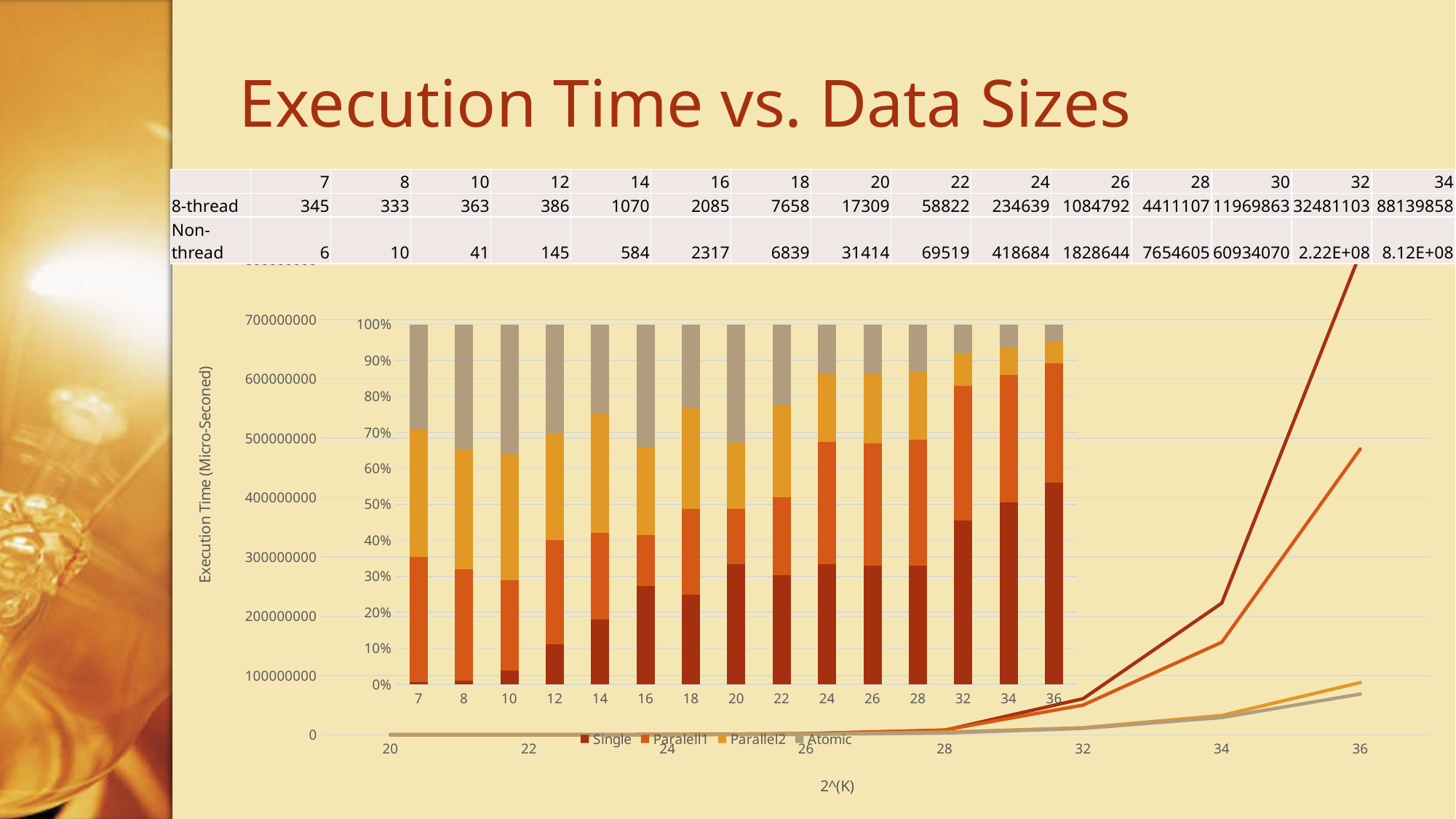
In the stacked bar chart, which category has the largest Single share? 36 In the stacked bar chart, is the Single share for category 8 greater or less than 10%? less How many categories are shown along the x axis of the stacked bar chart? 15 What is the y-axis label of the line chart behind the bars? Execution Time (Micro-Seconed) What kind of chart is the chart with the percentage axis on the slide? bar chart How many series does the legend of the stacked bar chart list? 4 In the stacked bar chart, is the Single share for category 16 greater or less than 20%? greater What are the legend entries of the stacked bar chart? Single, Paralell1, Parallel2, Atomic In the line chart behind the bars, is the value of the topmost line at x = 36 greater or less than 700000000? greater In the line chart behind the bars, do the lines rise or fall as the x axis goes from 20 to 36? rise